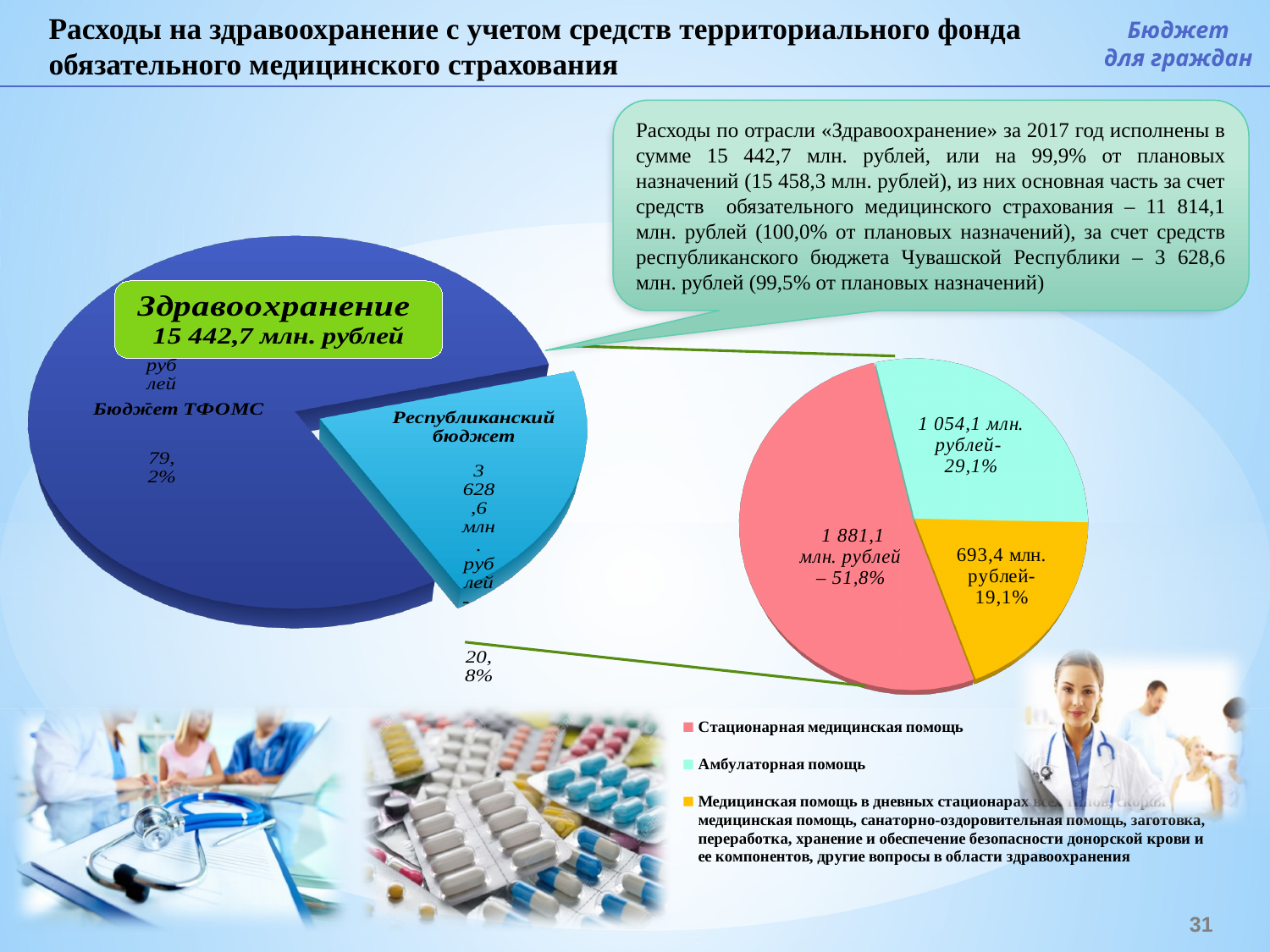
On the left pie chart, what share does Республиканский бюджет have? 20,8% On the right pie chart, what is the difference in percentage points between Стационарная медицинская помощь and Амбулаторная помощь? 22,7 On the right pie chart, what is the value in млн. рублей for the yellow slice (Медицинская помощь в дневных стационарах...)? 693,4 млн. рублей On the right pie chart, what is the value for Стационарная медицинская помощь? 1 881,1 млн. рублей – 51,8% On the right pie chart, which is larger: Амбулаторная помощь or the yellow slice for Медицинская помощь в дневных стационарах? Амбулаторная помощь On the left pie chart, what share does Бюджет ТФОМС have? 79,2% On the left pie chart, what is the value in млн. рублей for Республиканский бюджет? 3 628,6 млн. рублей On the right pie chart, what share does Амбулаторная помощь have? 29,1% On the right pie chart, how many slices are there? 3 On the right pie chart, which category has the largest slice? Стационарная медицинская помощь What type of chart is the chart on the right side of the slide? Pie chart On the right pie chart, which category has the smallest slice? Медицинская помощь в дневных стационарах (yellow slice)